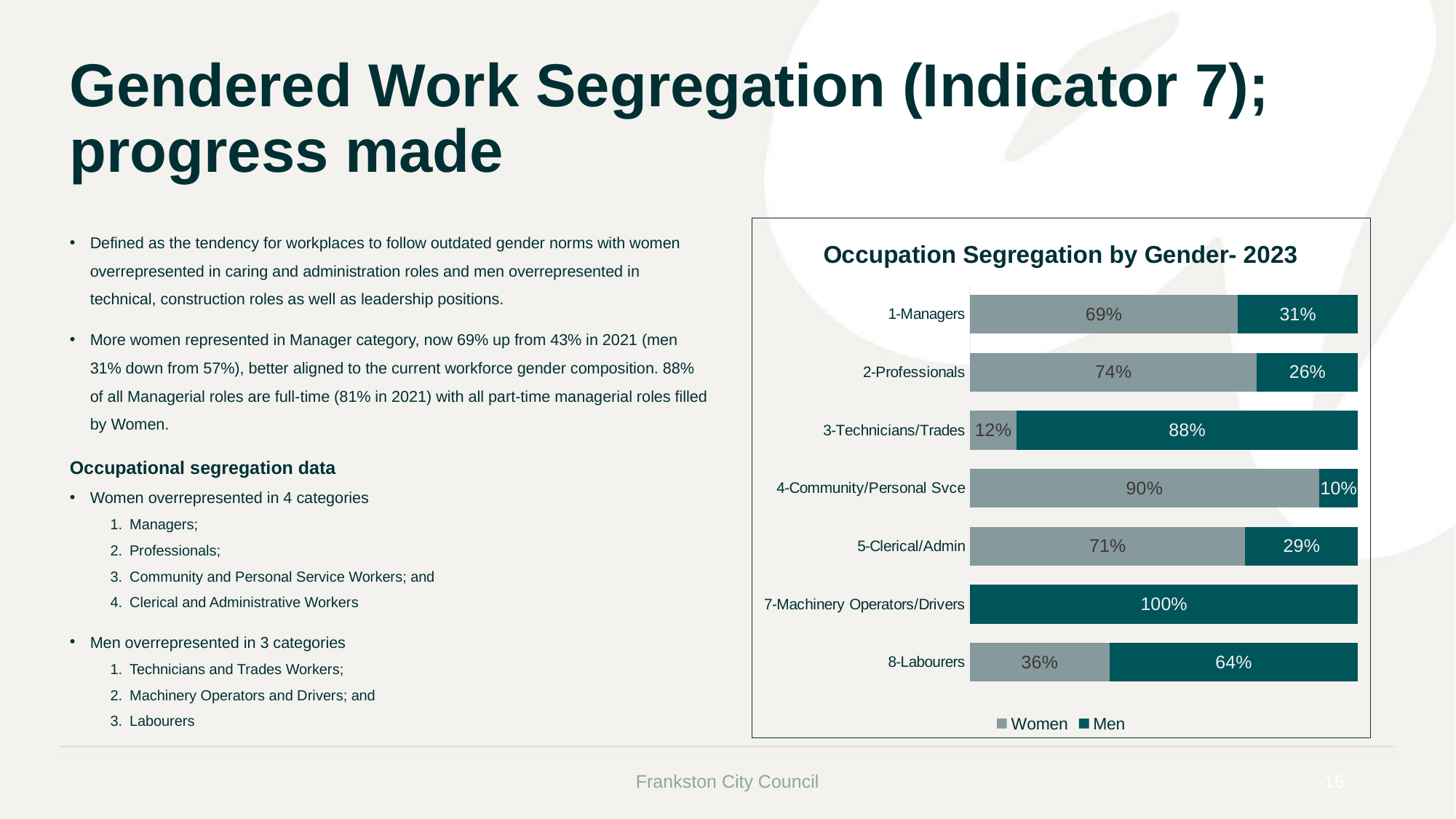
What is the difference between the Women and Men values for 5-Clerical/Admin? 42% How many occupation categories are shown in the chart? 7 What is the Men value for 8-Labourers? 64% What is the Women value for 4-Community/Personal Svce? 90% Which is larger, the Women value for 2-Professionals or the Women value for 1-Managers? 2-Professionals Which category has the highest Men share? 7-Machinery Operators/Drivers What is the title of the chart? Occupation Segregation by Gender- 2023 Which category has the highest Women share? 4-Community/Personal Svce What kind of chart is shown? Stacked bar chart What is the Women value for 1-Managers? 69% What is the Men value for 3-Technicians/Trades? 88% How many series does the legend list? 2